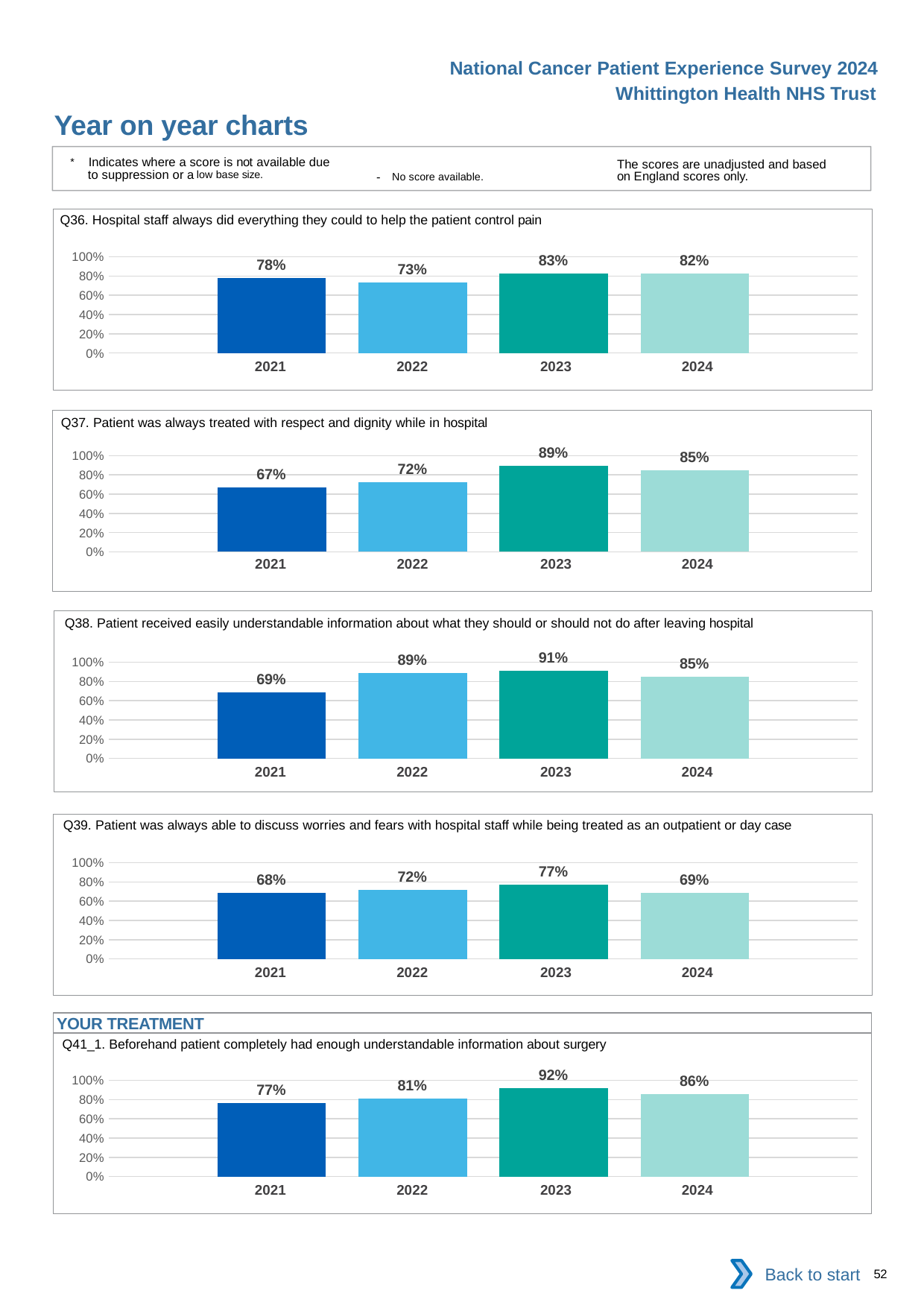
In the Q37 chart (patient was always treated with respect and dignity while in hospital), do the values rise or fall from 2021 to 2023? Rise In the Q36 chart (hospital staff always did everything they could to help the patient control pain), what is the value for 2022? 73% In the Q36 chart (hospital staff always did everything they could to help the patient control pain), what is the value for 2023? 83% In the Q39 chart (patient was always able to discuss worries and fears with hospital staff), which is larger, the 2022 value or the 2024 value? 2022 In the Q41_1 chart (beforehand patient completely had enough understandable information about surgery), what is the value for 2023? 92% In the Q41_1 chart (beforehand patient completely had enough understandable information about surgery), what is the difference between the 2023 and 2024 values? 6 percentage points In the Q37 chart (patient was always treated with respect and dignity while in hospital), which year has the lowest value? 2021 In the Q37 chart (patient was always treated with respect and dignity while in hospital), which year has the highest value? 2023 In the Q38 chart (patient received easily understandable information about what they should or should not do after leaving hospital), what is the difference between the 2022 and 2021 values? 20 percentage points In the Q39 chart (patient was always able to discuss worries and fears with hospital staff while being treated as an outpatient or day case), what is the value for 2024? 69% How many years (categories) are shown in the Q36 chart? 4 What type of chart is used for Q38 (patient received easily understandable information about what they should or should not do after leaving hospital)? Bar chart